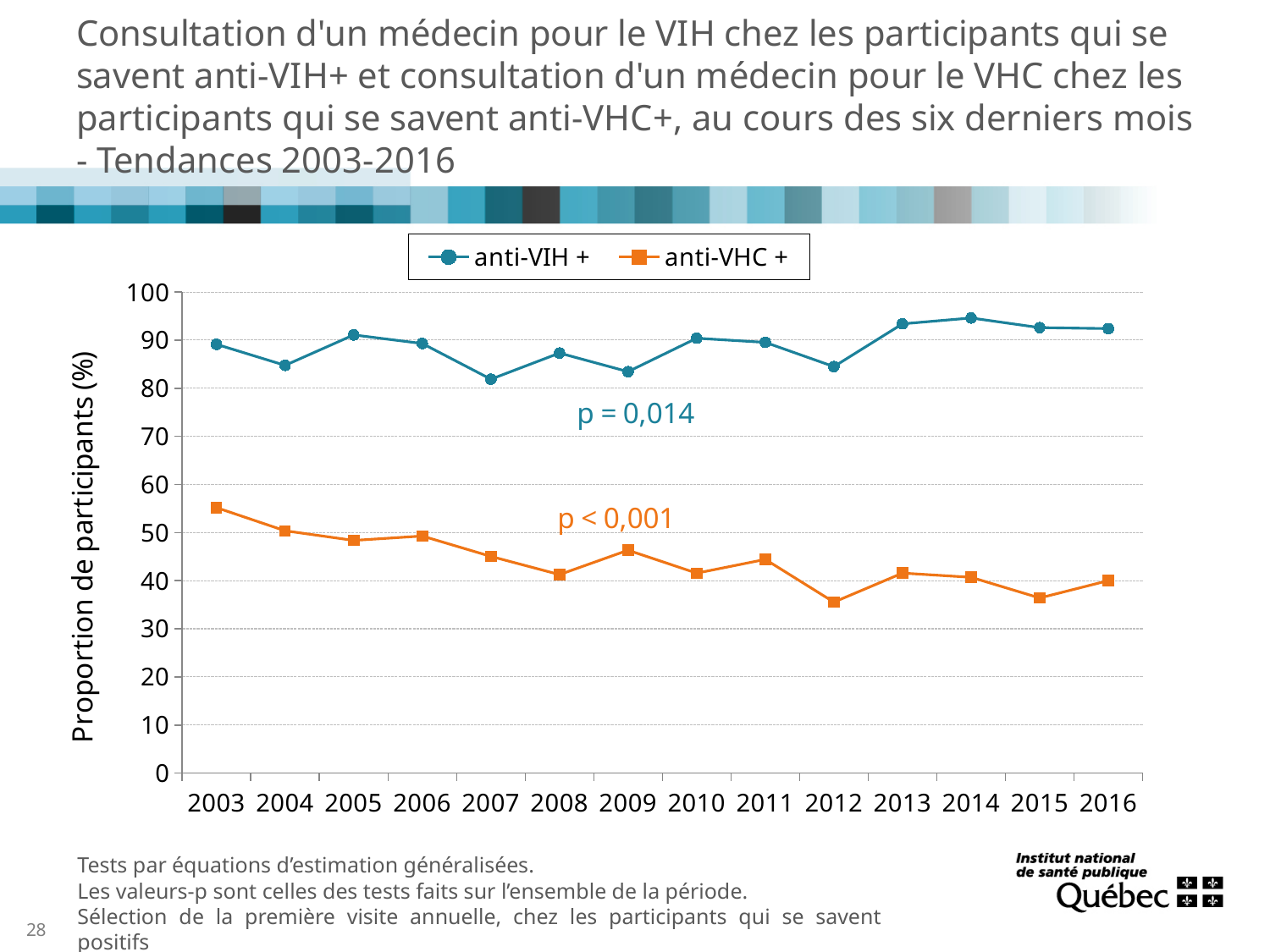
Is the value for anti-VIH + in 2003 greater or less than 80? greater How many years are plotted along the x axis? 14 What p-value is shown for the anti-VHC + series? p < 0,001 Is the value for anti-VHC + in 2008 greater or less than 50? less Does the anti-VHC + series generally rise or fall from 2003 to 2016? fall Is the value for anti-VHC + in 2003 greater or less than 50? greater What is the title of the y axis? Proportion de participants (%) What kind of chart is shown on the slide? line chart How many series does the legend list? 2 Which series has the highest value in 2003? anti-VIH + In which year is the anti-VHC + series at its highest? 2003